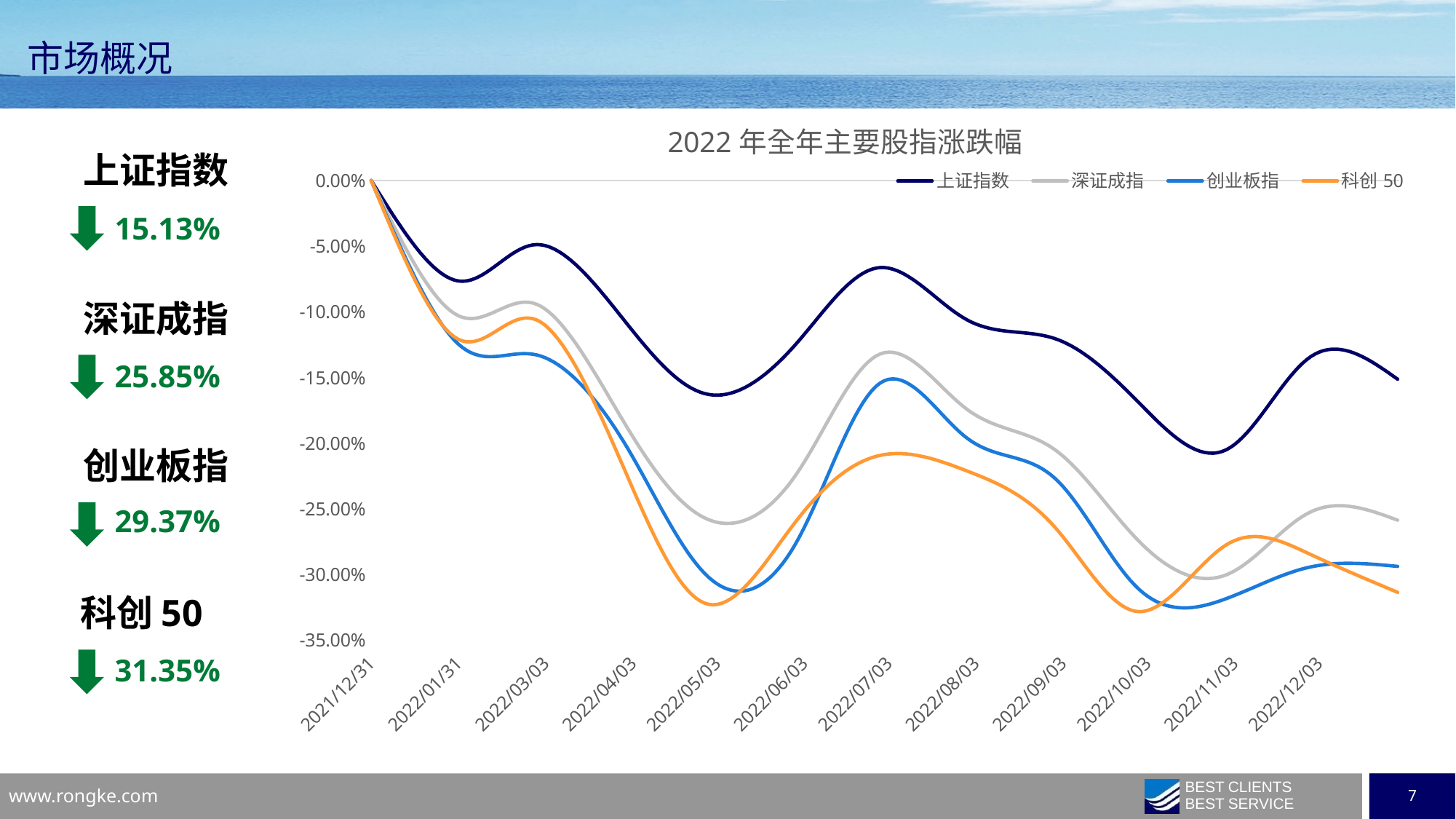
How many date labels are shown along the x axis of the chart? 12 Which colour is used for the 科创 50 line in the chart? orange How many series does the chart legend list? 4 Do the values of the 上证指数 line rise or fall overall from 2021/12/31 to 2022/12/03? fall At 2022/08/03, which series has the lowest value? 科创 50 At 2022/08/03, which series has the highest value? 上证指数 What kind of chart is shown on the slide? line chart At 2022/03/03, which is higher: 深证成指 or 创业板指? 深证成指 Is the value for 上证指数 at 2022/07/03 greater or less than -10.00%? greater What is the title of the chart? 2022 年全年主要股指涨跌幅 Is the value for 科创 50 at 2022/05/03 greater or less than -30.00%? less Is the value for 深证成指 at 2022/12/03 greater or less than -20.00%? less